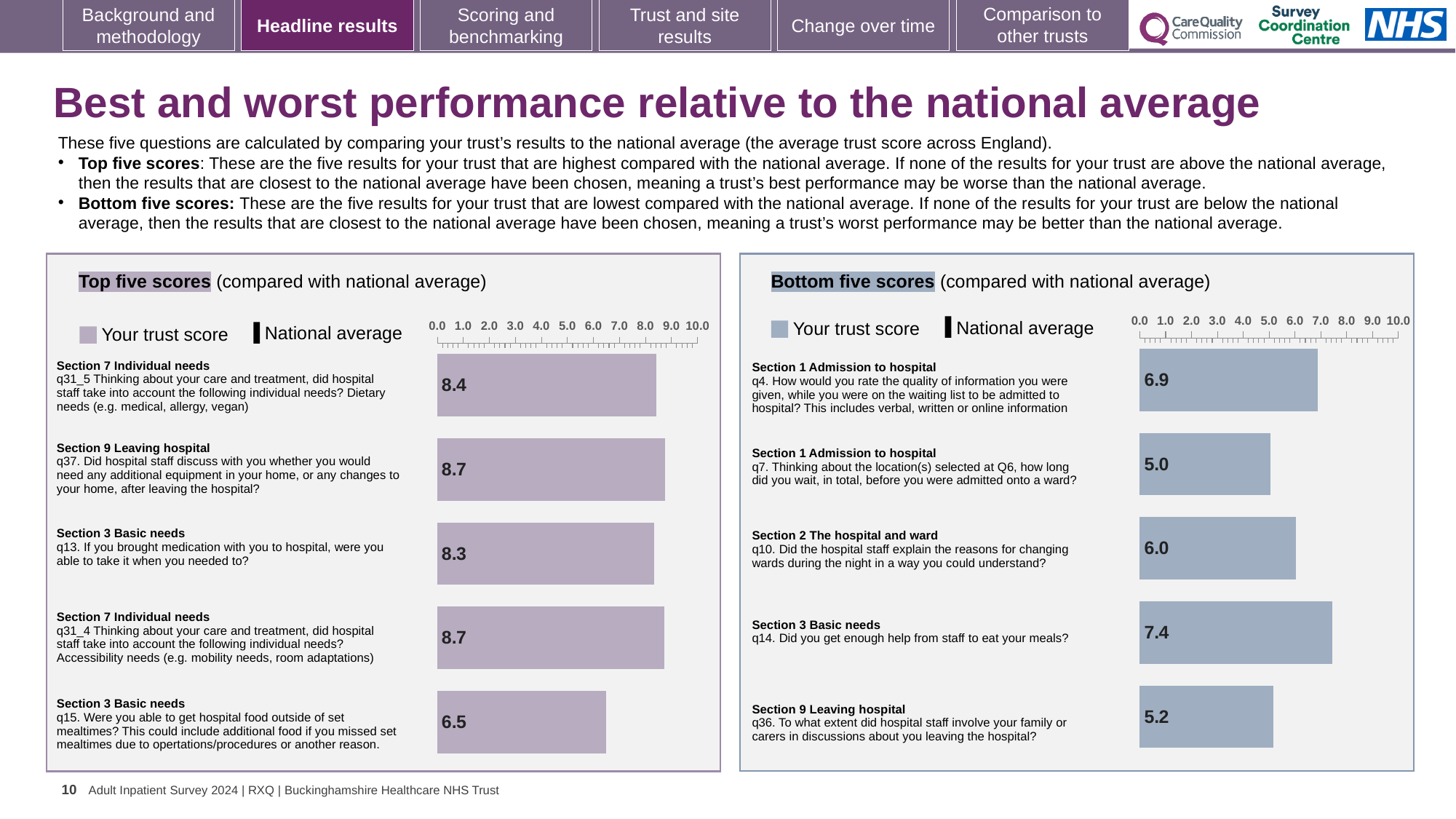
How many bars are plotted in the Bottom five scores chart? 5 In the Top five scores chart, what is the trust score for q13 (If you brought medication with you to hospital, were you able to take it when you needed to?)? 8.3 In the Bottom five scores chart, which has the larger trust score: q4 (quality of information while on the waiting list) or q10 (reasons for changing wards during the night)? q4 In the Top five scores chart, is the trust score for q37 (additional equipment or changes to your home) greater or less than 8.0? greater In the Bottom five scores chart, what is the trust score for q14 (Did you get enough help from staff to eat your meals?)? 7.4 In the Top five scores chart, what is the trust score for q31_4 (Accessibility needs)? 8.7 In the Bottom five scores chart, what is the difference between the highest trust score (q14) and the lowest trust score (q7)? 2.4 In the Top five scores chart, what is the difference between the trust score for q31_5 (Dietary needs) and q15 (food outside of set mealtimes)? 1.9 In the Bottom five scores chart, which question has the lowest trust score? q7 (How long did you wait, in total, before you were admitted onto a ward?) What kind of chart is the Top five scores chart? bar chart In the Bottom five scores chart, which question has the highest trust score? q14 (Did you get enough help from staff to eat your meals?) In the Top five scores chart, which question has the lowest trust score? q15 (Were you able to get hospital food outside of set mealtimes?)